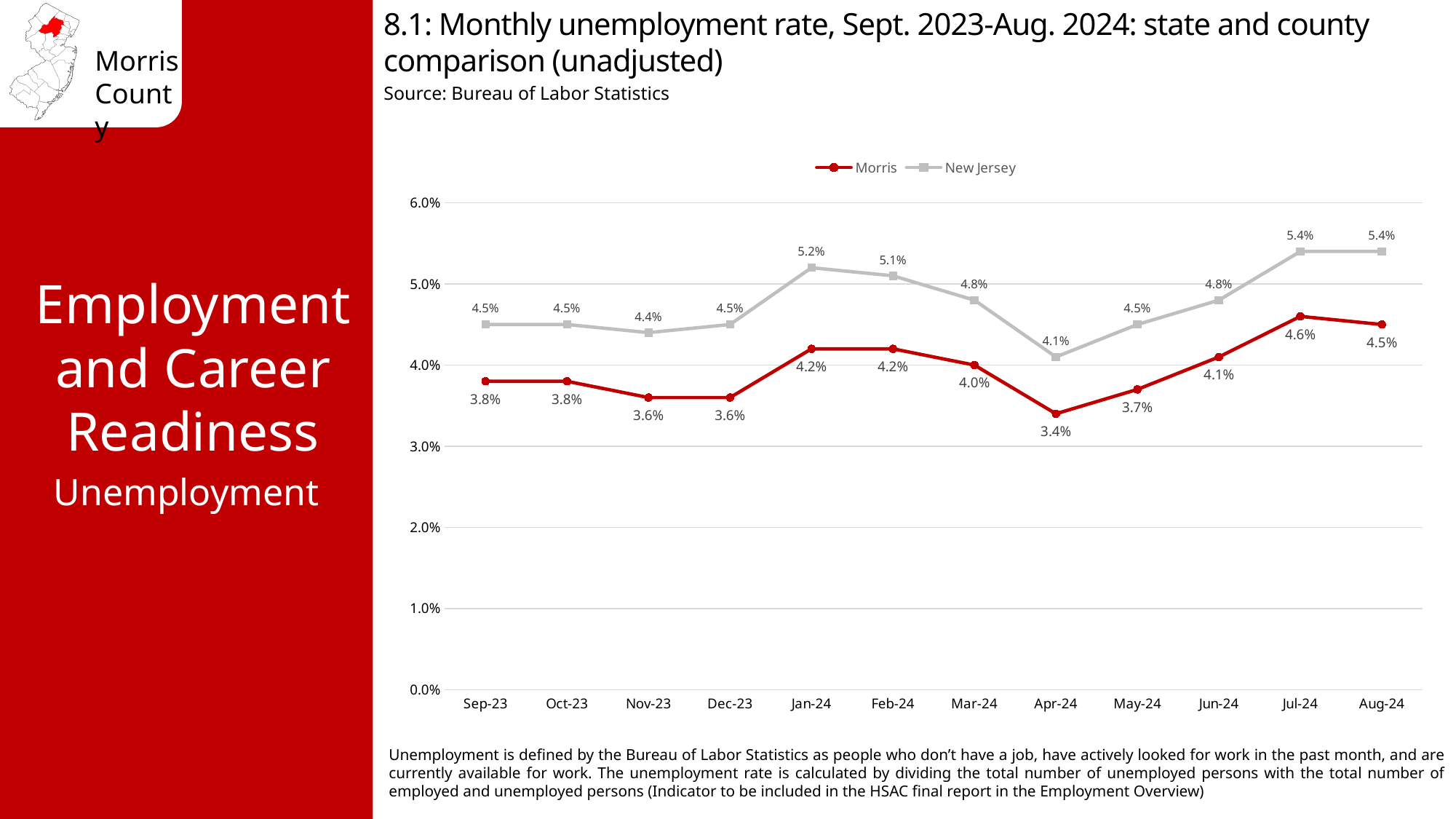
In which month was the Morris unemployment rate lowest? Apr-24 Which series had the higher unemployment rate in Mar-24, Morris or New Jersey? New Jersey In which month was the Morris unemployment rate highest? Jul-24 What is the difference between the New Jersey and Morris unemployment rates in Aug-24? 0.9% How many series does the legend list? 2 What was the Morris unemployment rate in Apr-24? 3.4% What is the source cited for the chart? Bureau of Labor Statistics What kind of chart is shown on the slide? Line chart Did the Morris unemployment rate rise or fall from Apr-24 to Jul-24? Rise What was the Morris unemployment rate in Jul-24? 4.6% How many months are shown on the x axis? 12 What was the New Jersey unemployment rate in Jan-24? 5.2%